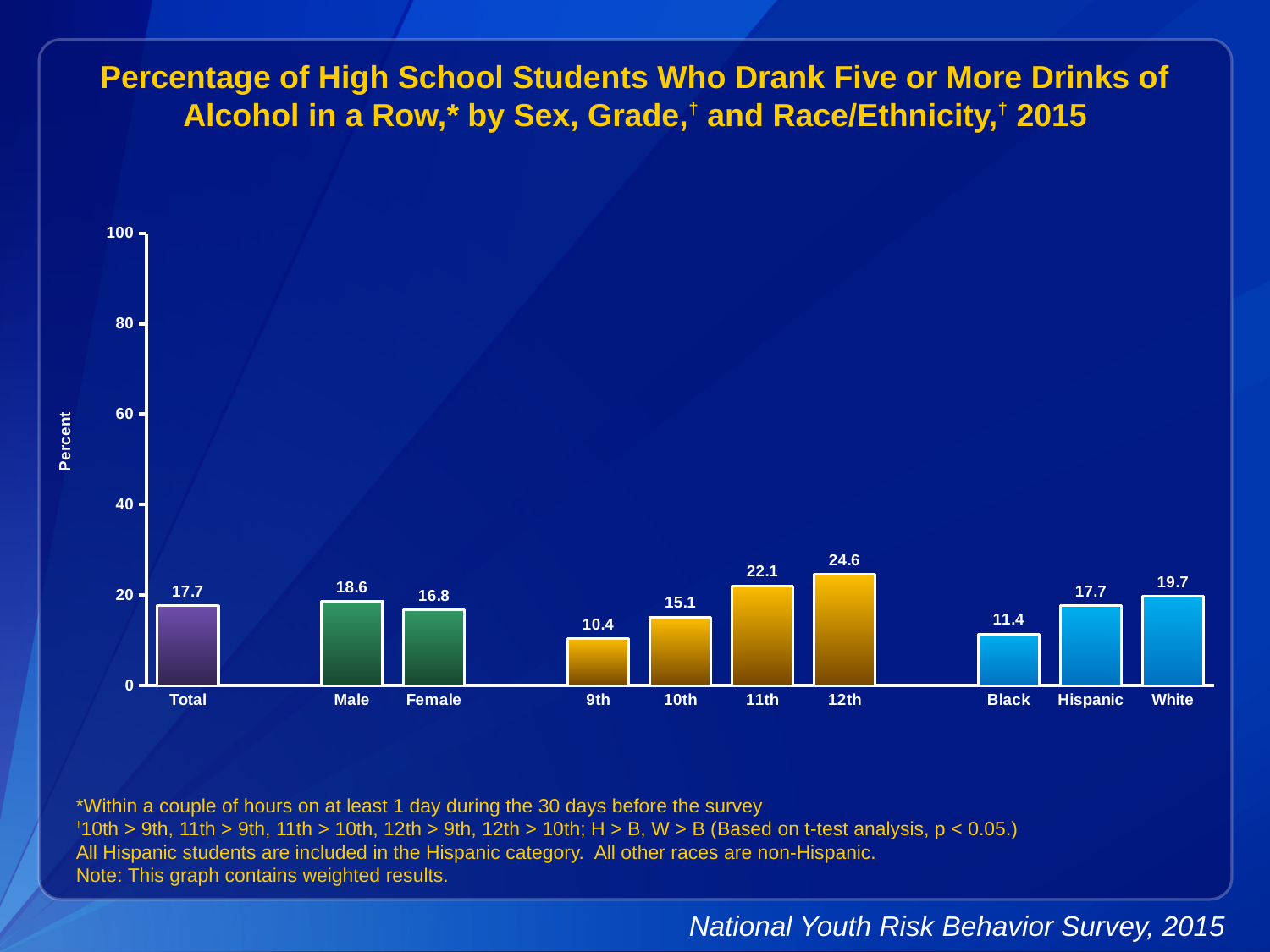
What is the difference between the values for Male and Female? 1.8 Is the value for 11th grade greater or less than 20? greater Which is larger, the value for White or the value for Hispanic? White How many categories are shown on the x axis? 10 What is the value for 12th grade? 24.6 What is the value for Total? 17.7 What kind of chart is this? bar chart Do the values rise or fall from 9th grade to 12th grade? rise Which category has the highest value? 12th Which category has the lowest value? 9th What is the value for Black students? 11.4 What is the difference between the values for 12th and 9th grade? 14.2